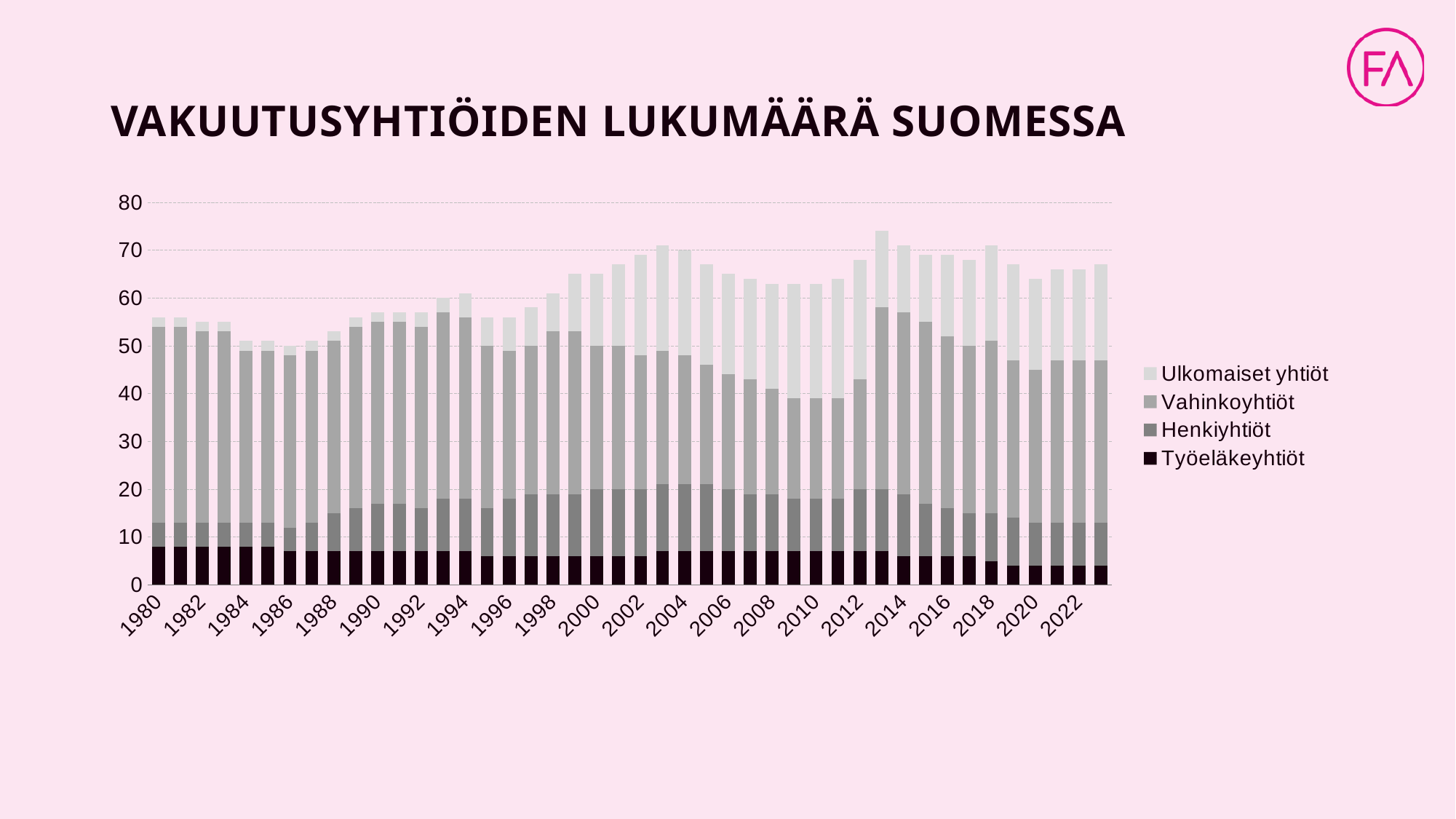
How many series does the legend list? 4 Which year has the highest total bar? 2013 What is the title of the chart? VAKUUTUSYHTIÖIDEN LUKUMÄÄRÄ SUOMESSA Do the total bars rise or fall from 2013 to 2020? fall Which series is listed first (at the top) in the legend? Ulkomaiset yhtiöt Is the total for 2000 greater or less than 60? greater What kind of chart is shown on the slide? Stacked bar chart How many bars (years) are plotted in the chart? 44 Which has the larger total bar, 1980 or 2003? 2003 Is the value for Työeläkeyhtiöt in 2022 greater or less than 10? less Is the total for 2013 greater or less than 70? greater